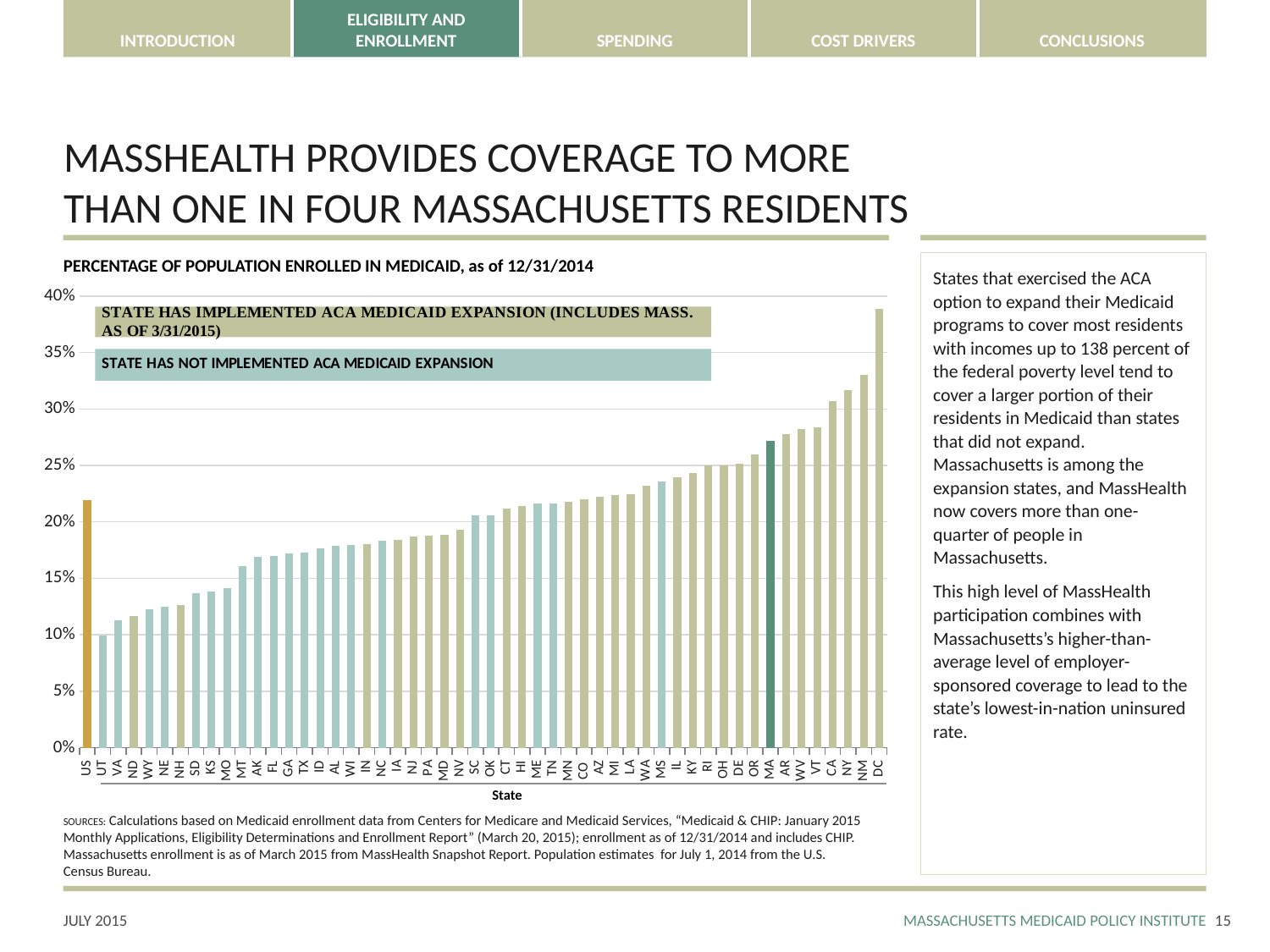
What kind of chart is shown on the slide? bar chart Which has a higher percentage of population enrolled in Medicaid, MA or FL? MA Is the value for FL greater or less than 20%? less Is the value for US greater or less than 20%? greater How many bars are plotted on the chart? 52 Which state has the lowest percentage of population enrolled in Medicaid? UT Is the value for DC greater or less than 35%? greater Which has a higher percentage of population enrolled in Medicaid, NY or DC? DC Which state has the highest percentage of population enrolled in Medicaid? DC How many categories does the chart's legend list? 2 Do the bar values generally rise or fall from left to right along the x axis? rise